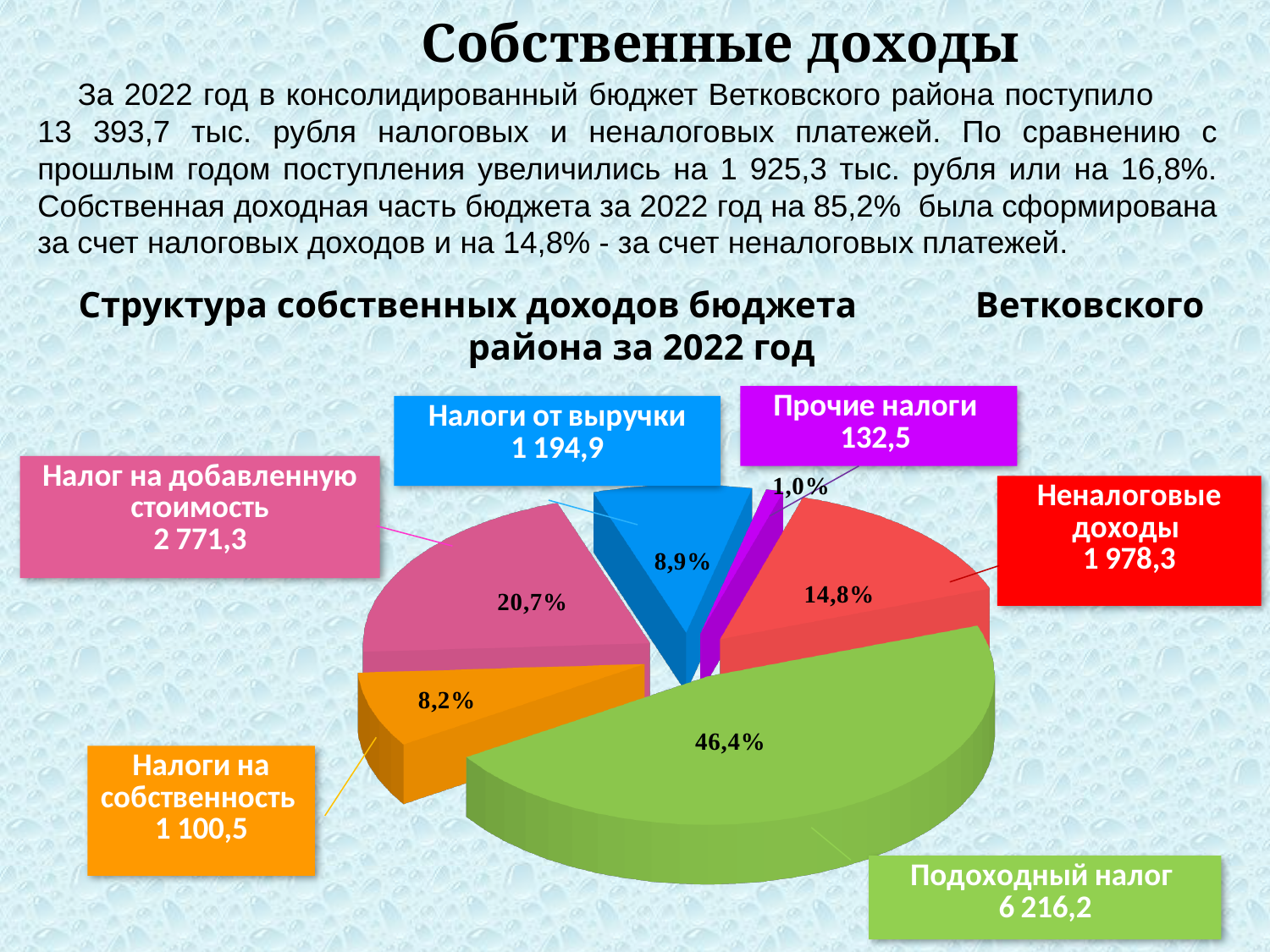
What percentage is shown for Налоги от выручки? 8,9% What kind of chart is shown on the slide? pie chart How many slices does the pie chart have? 6 What percentage is shown for Прочие налоги? 1,0% What is the value shown for Неналоговые доходы? 1 978,3 What is the value shown for Подоходный налог? 6 216,2 Which is larger, Налоги на собственность or Налог на добавленную стоимость? Налог на добавленную стоимость What is the difference between the values for Неналоговые доходы and Налоги от выручки? 783,4 Which category has the largest slice of the pie? Подоходный налог Which category has the smallest slice of the pie? Прочие налоги What is the title of the chart? Структура собственных доходов бюджета Ветковского района за 2022 год What share of the pie does Налог на добавленную стоимость represent? 20,7%